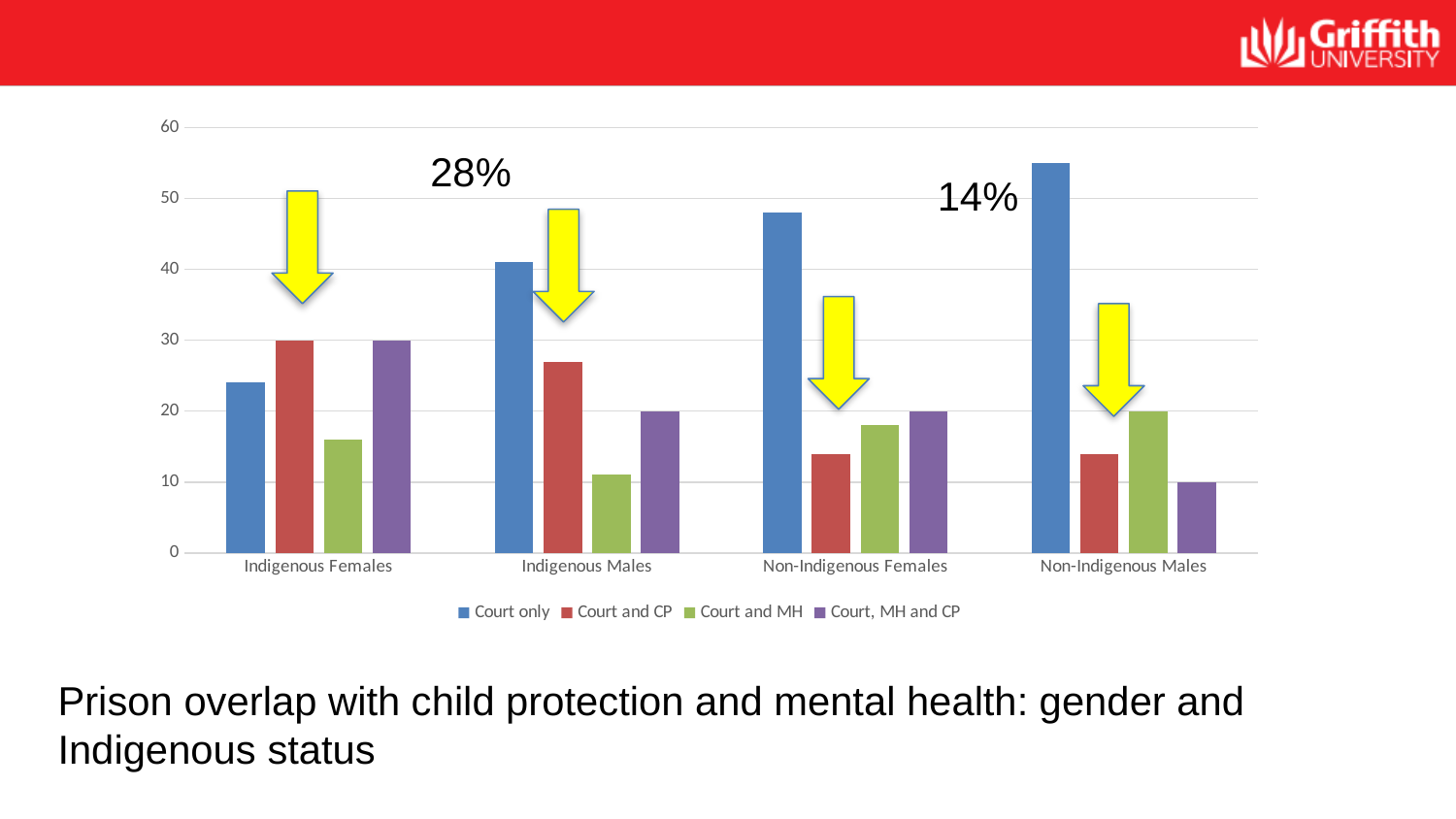
Is the 'Court only' value for Indigenous Females greater or less than 30? less Which category has the highest 'Court only' value? Non-Indigenous Males Which category has the lowest 'Court, MH and CP' value? Non-Indigenous Males Which is larger: the 'Court only' value for Indigenous Females or for Non-Indigenous Females? Non-Indigenous Females What is the 'Court, MH and CP' value for Non-Indigenous Males? 10 How many series does the chart's legend list? 4 Is the 'Court only' value for Non-Indigenous Males greater or less than 50? greater What kind of chart is shown on the slide? Bar chart Which is larger: the 'Court and CP' value for Indigenous Females or for Non-Indigenous Males? Indigenous Females What percentage is annotated above the Indigenous Males group in the chart? 28% How many categories are shown on the x axis of the chart? 4 Is the 'Court and MH' value for Indigenous Males greater or less than 20? less